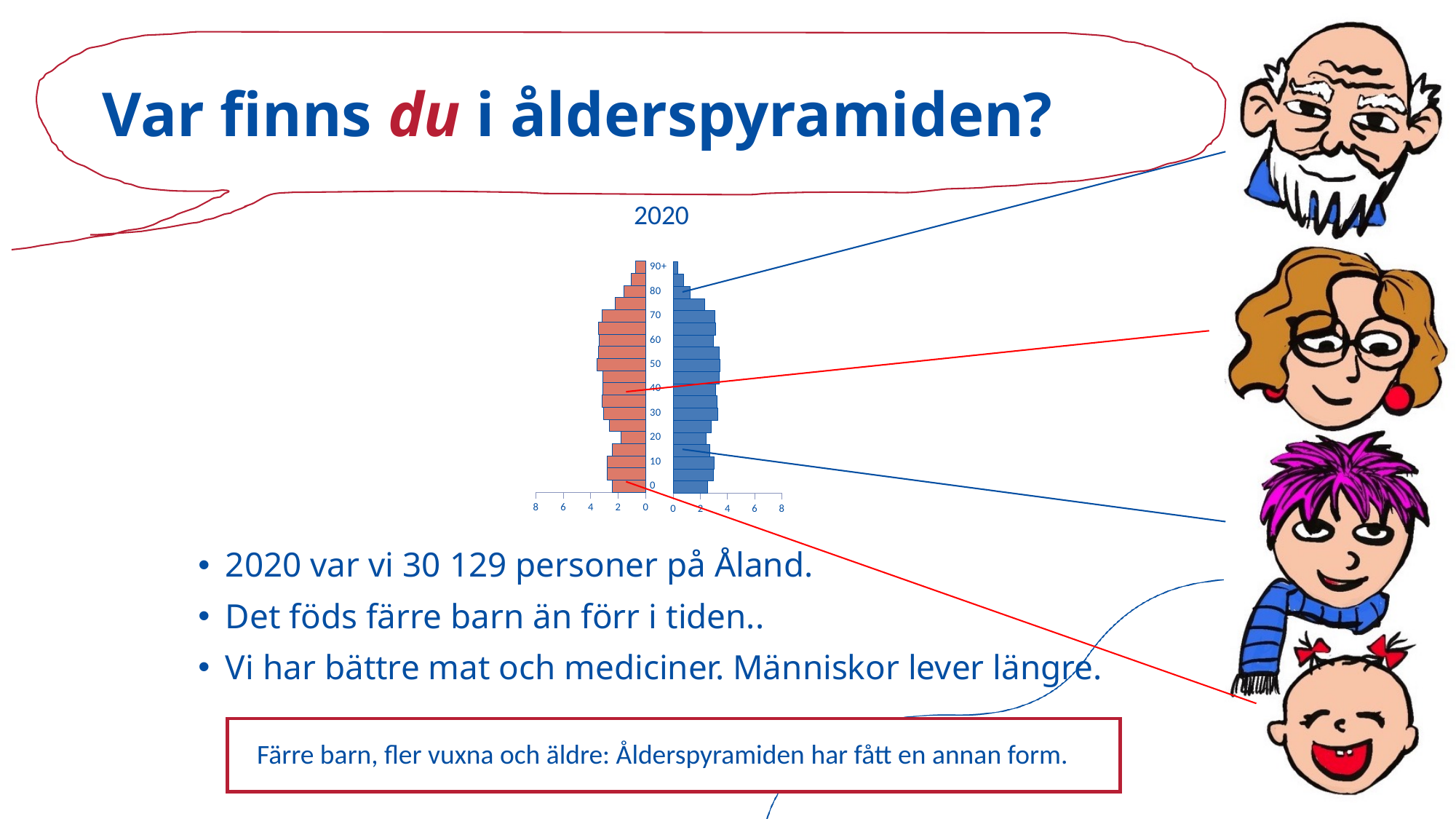
How many age-group labels are shown on the vertical axis of the chart? 10 What is the highest value shown on the horizontal axis of the chart? 8 Is the value of the blue bar at age 90+ greater or less than 2? less Is the value of the red bar at age 60 greater or less than 6? less What is the topmost age-group label on the vertical axis of the chart? 90+ Is the value of the blue bar at age 50 greater or less than 6? less Which is larger, the blue bar at age 60 or the blue bar at age 90+? age 60 Do the blue bars get longer or shorter going from age 60 up to age 90+? shorter What is the title of the chart? 2020 What kind of chart is shown on the slide? bar chart Which is larger, the red bar at age 50 or the red bar at age 80? age 50